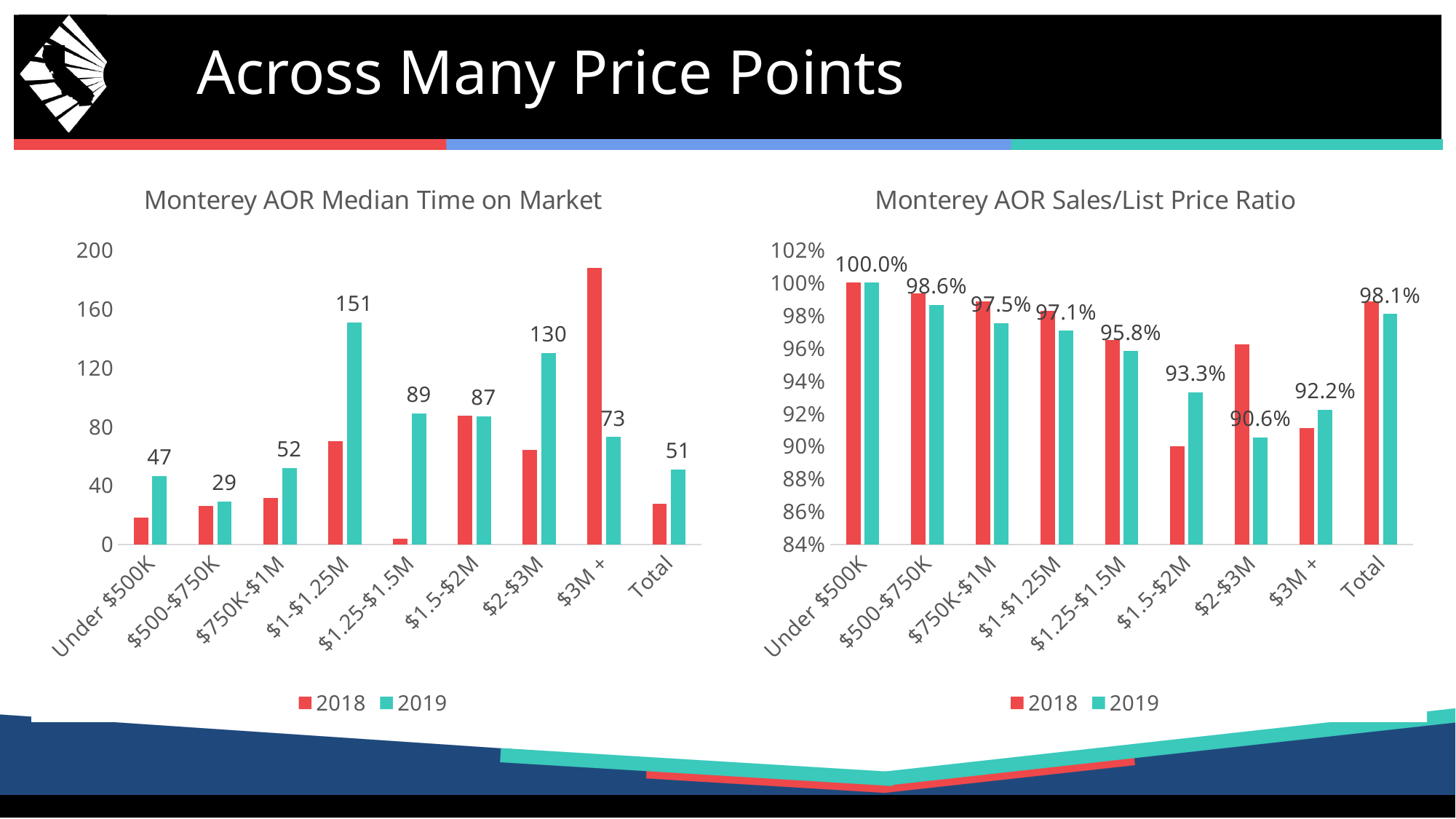
In the Monterey AOR Median Time on Market chart, which price range has the lowest 2019 value? $500-$750K In the Monterey AOR Median Time on Market chart, what is the difference between the 2019 values for $2-$3M and $3M +? 57 How many series does the legend of the Monterey AOR Median Time on Market chart list? 2 In the Monterey AOR Sales/List Price Ratio chart, is the 2018 value for $1.5-$2M greater or less than 92%? less In the Monterey AOR Sales/List Price Ratio chart, what is the 2019 value for $1.5-$2M? 93.3% What kind of chart is the Monterey AOR Sales/List Price Ratio chart? bar chart How many price categories are shown on the x axis of the Monterey AOR Median Time on Market chart? 9 In the Monterey AOR Sales/List Price Ratio chart, which has the larger 2019 value: $3M + or $2-$3M? $3M + In the Monterey AOR Median Time on Market chart, what is the 2019 value for $1-$1.25M? 151 In the Monterey AOR Sales/List Price Ratio chart, which price range has the lowest 2019 value? $2-$3M In the Monterey AOR Median Time on Market chart, which price range has the highest 2019 value? $1-$1.25M In the Monterey AOR Median Time on Market chart, is the 2018 value for $3M + greater or less than 160? greater